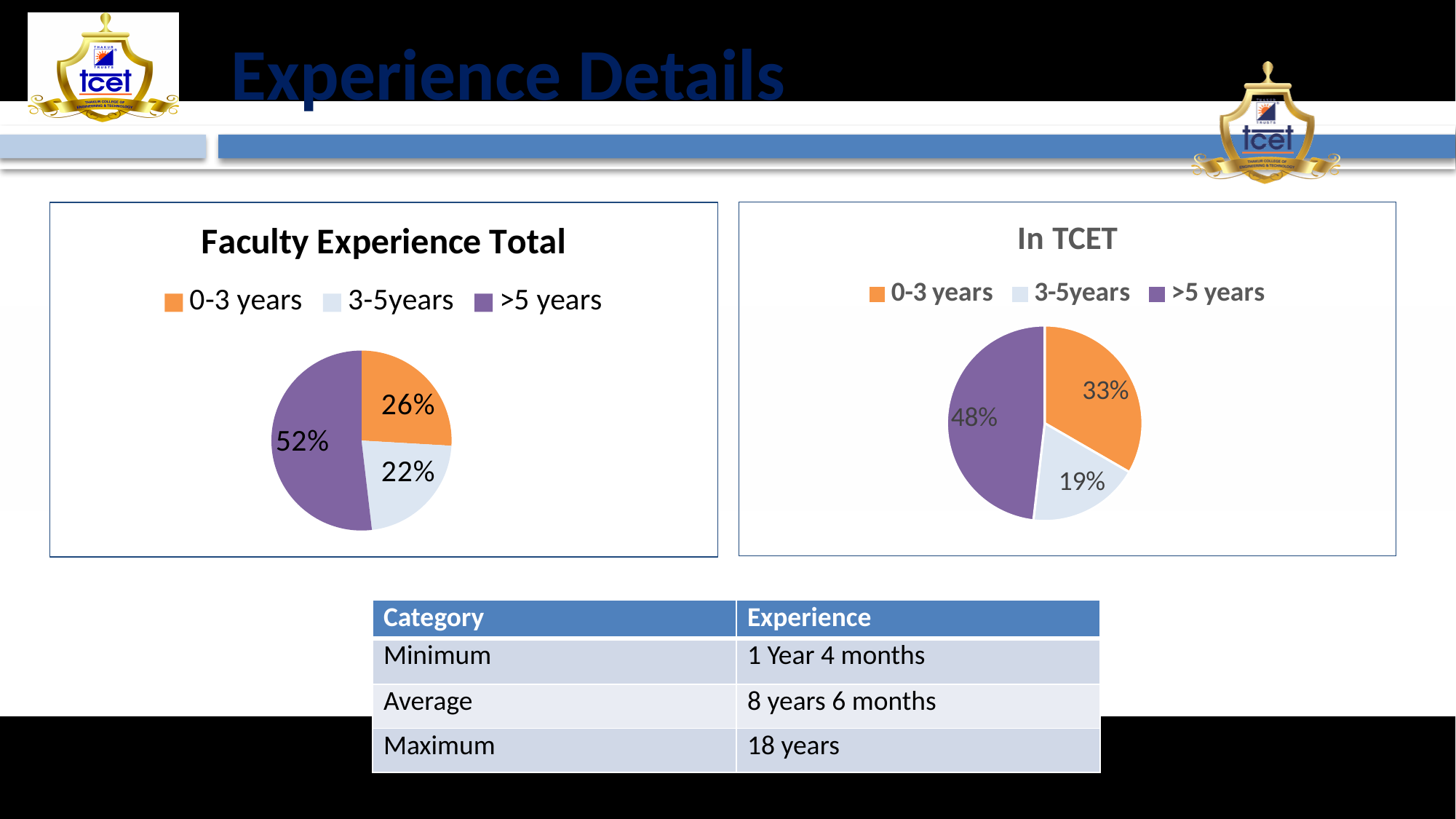
In the 'Faculty Experience Total' chart, which colour represents the 0-3 years category? Orange In the 'In TCET' chart, which category has the smallest share? 3-5years In the 'Faculty Experience Total' chart, what share of faculty have >5 years of experience? 52% In the 'In TCET' chart, what share of faculty have 0-3 years of experience? 33% In the 'In TCET' chart, what share of faculty have 3-5 years of experience? 19% In the 'Faculty Experience Total' chart, what is the difference between the >5 years share and the 0-3 years share? 26% How many categories does the 'In TCET' chart show? 3 In the 'In TCET' chart, what is the difference between the 0-3 years share and the 3-5years share? 14% In the 'In TCET' chart, which is larger: the share for 0-3 years or the share for 3-5years? 0-3 years In the 'Faculty Experience Total' chart, which category has the largest share? >5 years In the 'Faculty Experience Total' chart, what share of faculty have 0-3 years of experience? 26% What type of chart is the 'Faculty Experience Total' chart? Pie chart